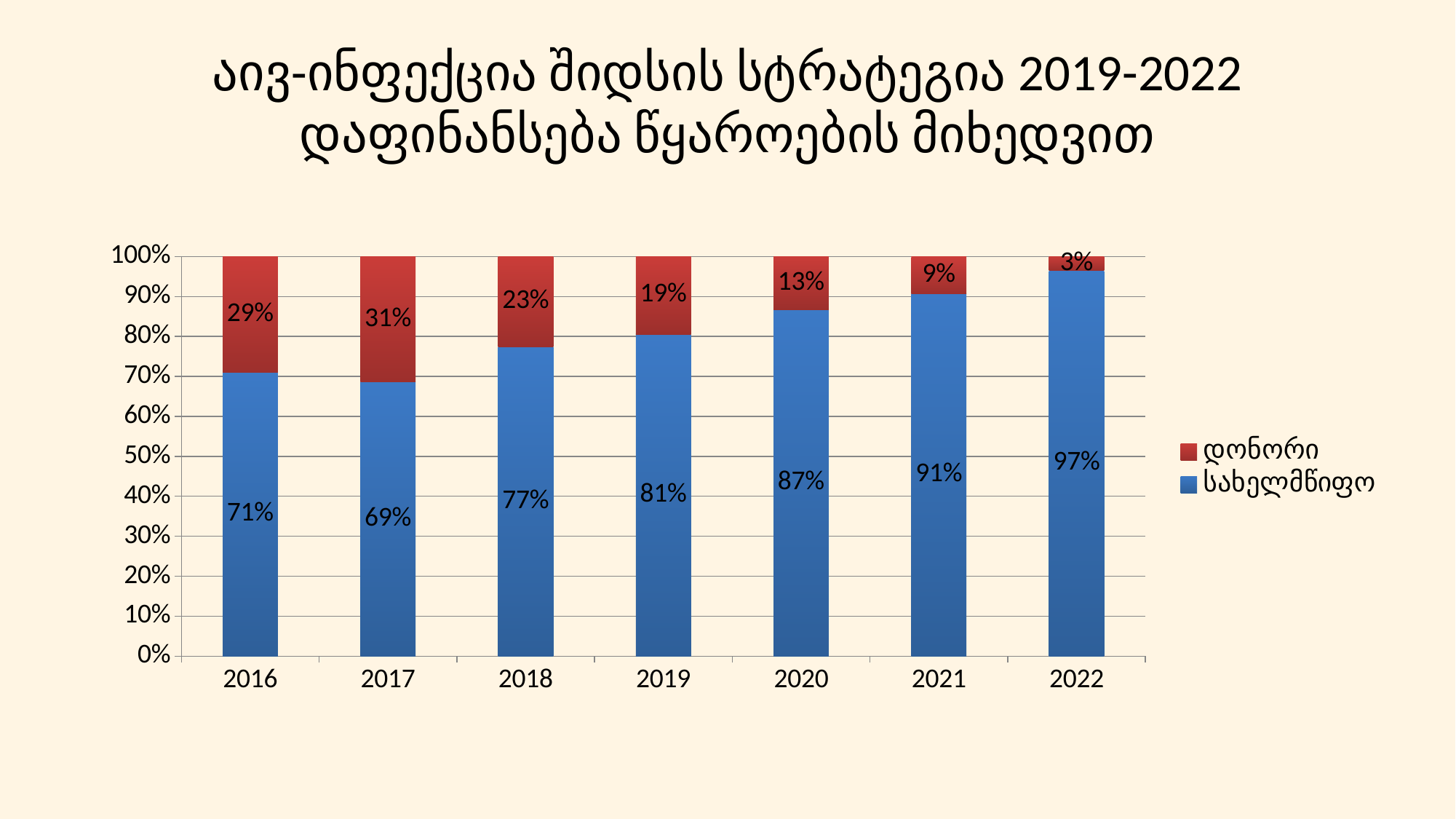
In which year is the სახელმწიფო share lowest? 2017 What is the value for სახელმწიფო in 2020? 87% Does the დონორი share rise or fall from 2017 to 2022? Fall How many series does the legend list? 2 What is the value for დონორი in 2017? 31% Which is larger: the დონორი value in 2018 or in 2019? 2018 What kind of chart is shown on the slide? Stacked bar chart What is the value for დონორი in 2022? 3% What is the value for სახელმწიფო in 2016? 71% What is the difference between the სახელმწიფო value in 2022 and in 2016? 26% In which year is the სახელმწიფო share highest? 2022 How many years are shown on the x axis? 7